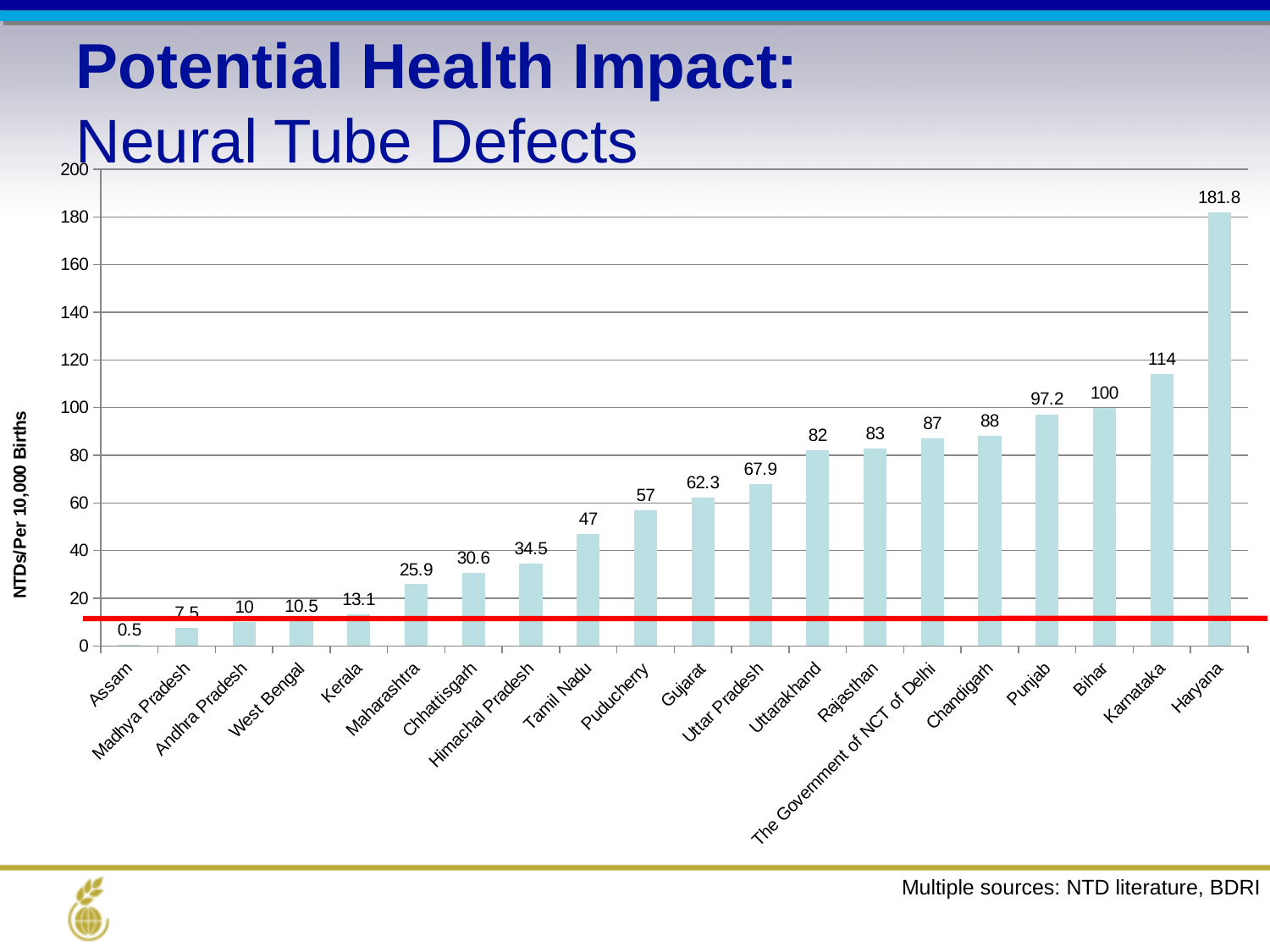
What is the value for Punjab? 97.2 Which has a larger value, Gujarat or Uttar Pradesh? Uttar Pradesh How many states or territories are shown on the x axis? 20 What is the value for Haryana? 181.8 What kind of chart is shown on the slide? Bar chart What is the label on the vertical axis? NTDs/Per 10,000 Births Which state has the highest value? Haryana What is the value for Tamil Nadu? 47 What is the difference between the values for Karnataka and Bihar? 14 Which state has the lowest value? Assam Do the values rise or fall from left to right along the x axis? Rise Is the value for Chandigarh greater or less than 80? greater